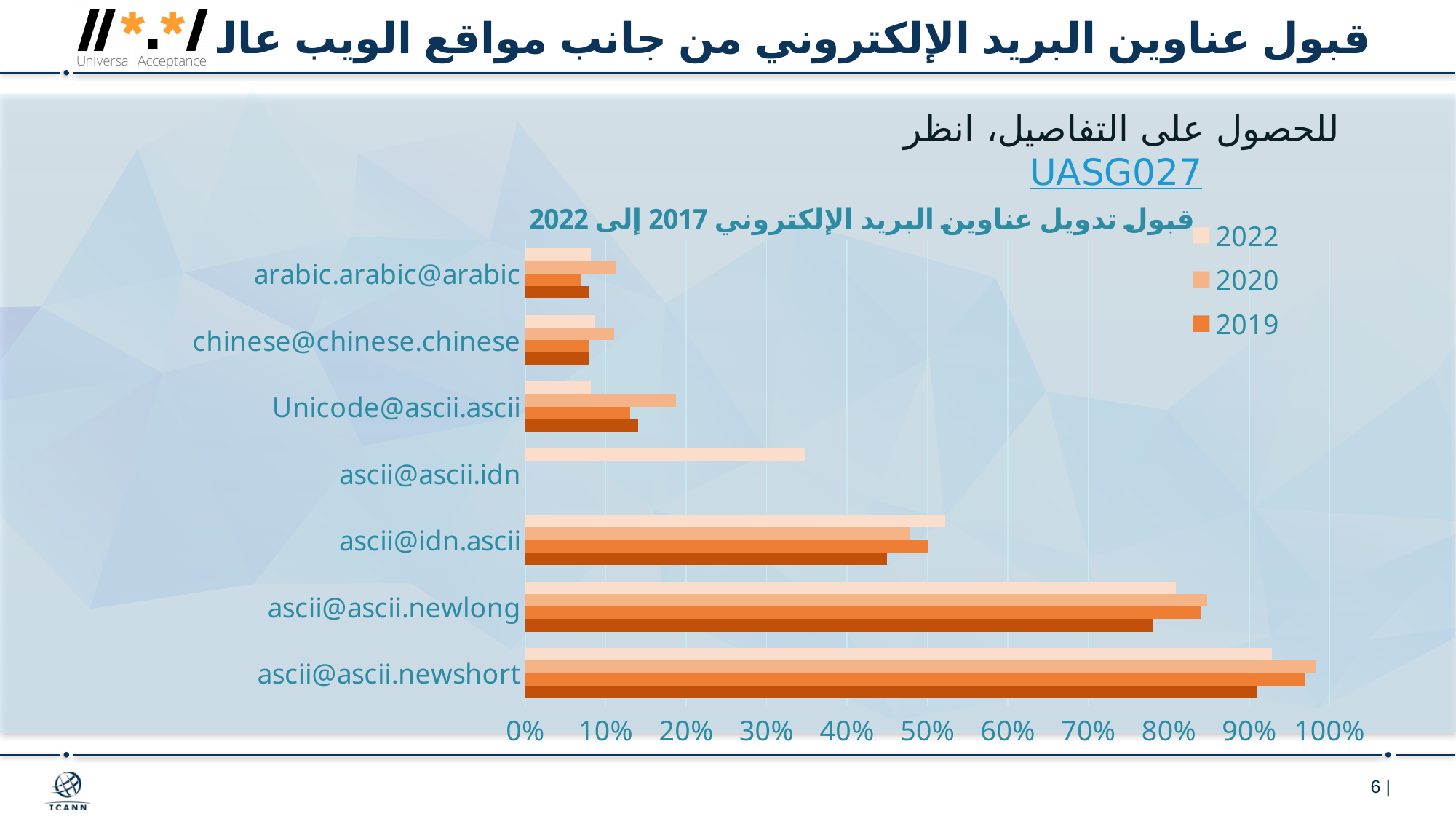
How many categories (email address formats) are listed on the chart's vertical axis? 7 Is the 2020 value for ascii@ascii.newshort greater or less than 90%? greater Is the 2019 value for ascii@ascii.newlong greater or less than 70%? greater What kind of chart is shown on the slide? bar chart For 2019, which is larger: ascii@ascii.newlong or ascii@idn.ascii? ascii@ascii.newlong How many series does the chart's legend list? 3 Which years are listed in the chart's legend? 2022, 2020, 2019 Which category has the longest bars overall on the chart? ascii@ascii.newshort Is the 2019 value for arabic.arabic@arabic greater or less than 10%? less